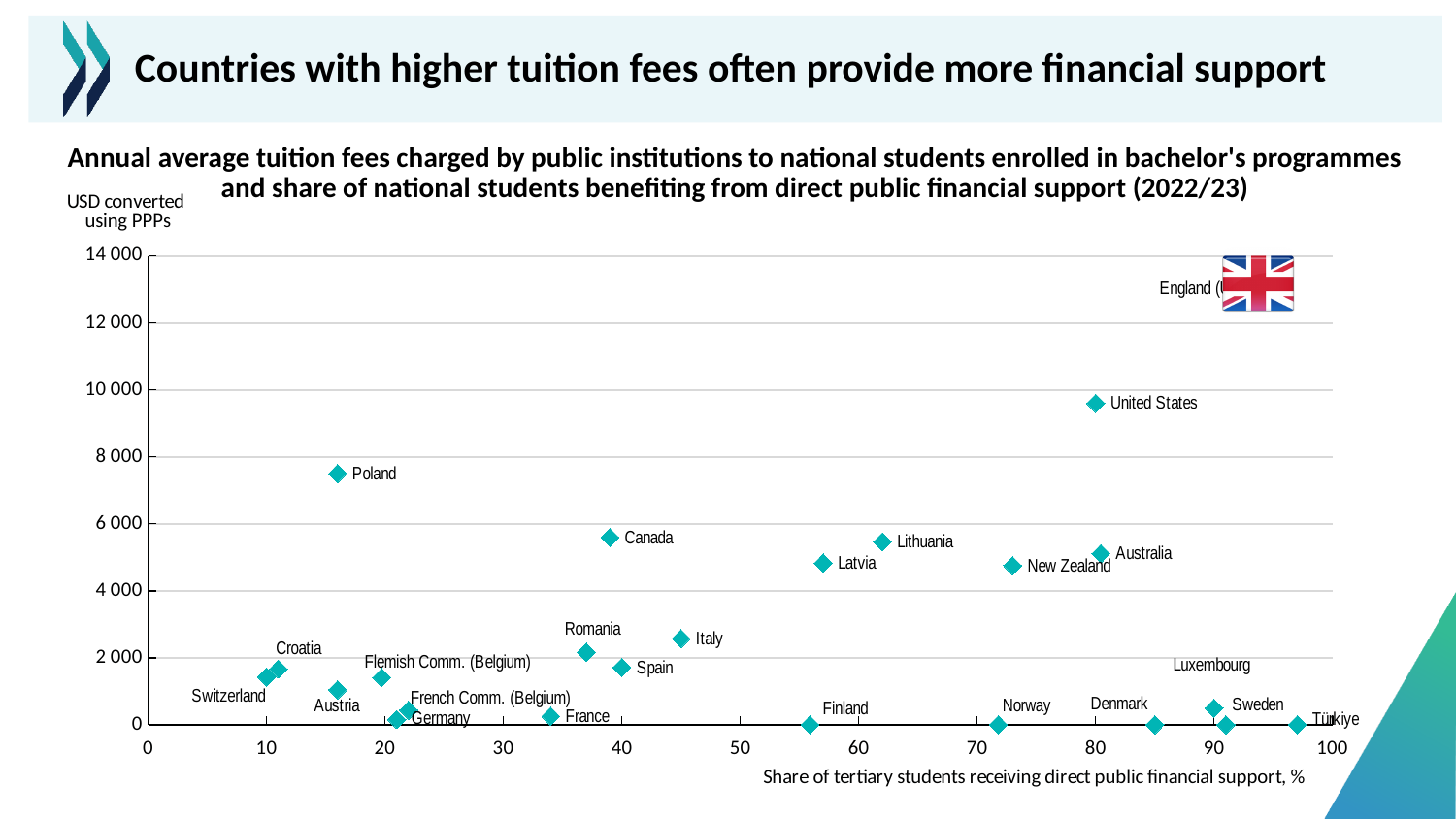
Which has the higher tuition fee, the United States or Australia? United States What is the label of the horizontal axis? Share of tertiary students receiving direct public financial support, % Is the tuition fee for Latvia greater or less than 6 000 USD? less Which country has the highest annual average tuition fee in the chart? England Which has the higher tuition fee, Italy or Spain? Italy Which has the higher tuition fee, Poland or Canada? Poland What kind of chart is shown on the slide? Scatter chart Which country has the highest share of tertiary students receiving direct public financial support? Türkiye Is the share of students receiving direct public financial support in Poland greater or less than 20%? less Is the tuition fee for the United States greater or less than 8 000 USD? greater